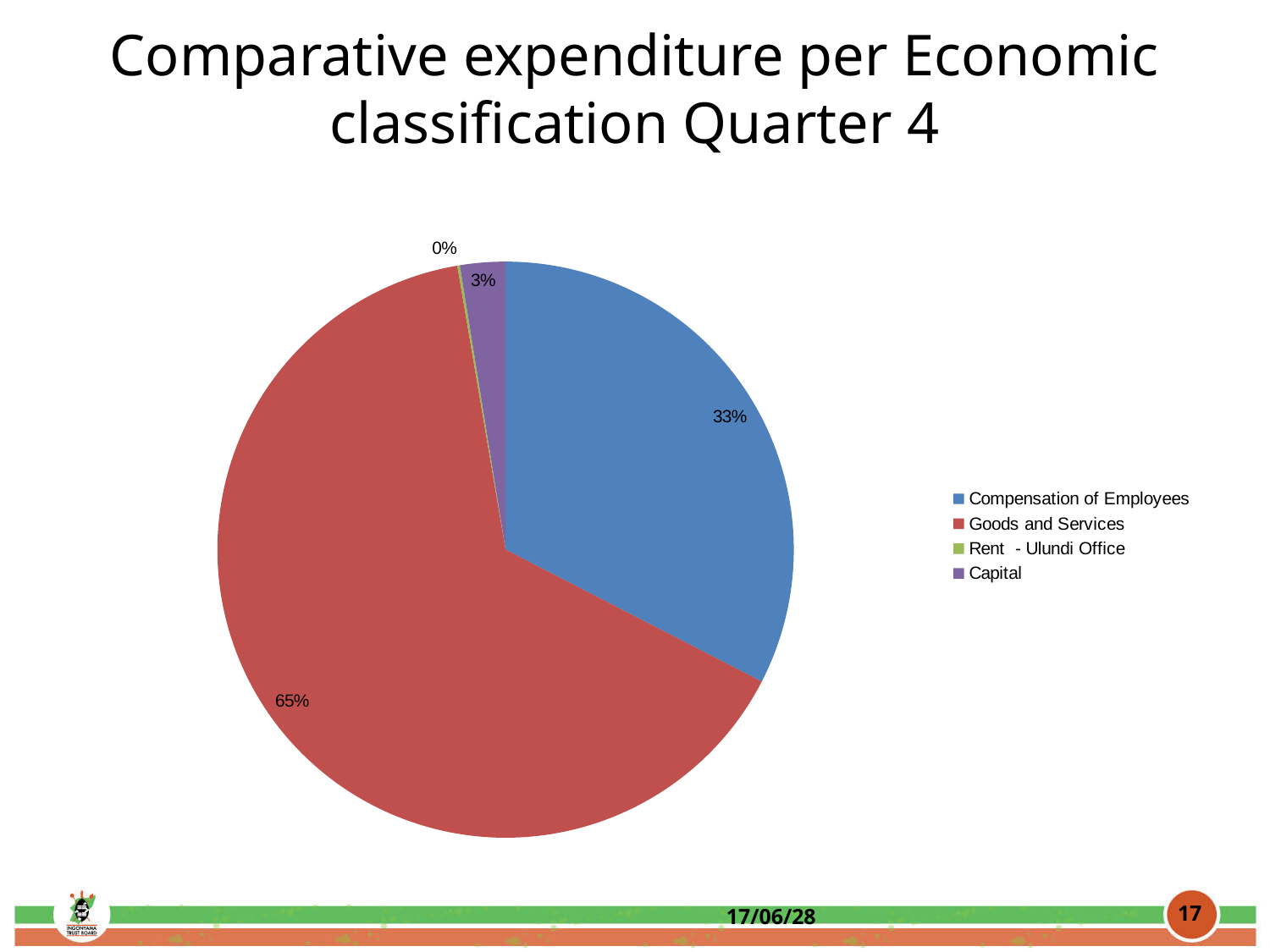
How many categories does the legend list? 4 What share of expenditure is Compensation of Employees? 33% What share of expenditure is Capital? 3% How many slices does the pie chart have? 4 What colour is the Goods and Services slice? red What is the difference in percentage points between Goods and Services and Compensation of Employees? 32 What share of expenditure is Rent - Ulundi Office? 0% Which is larger: the share for Compensation of Employees or the share for Capital? Compensation of Employees Which category has the smallest share of expenditure? Rent - Ulundi Office What type of chart is shown on the slide? pie chart Which category has the largest share of expenditure? Goods and Services